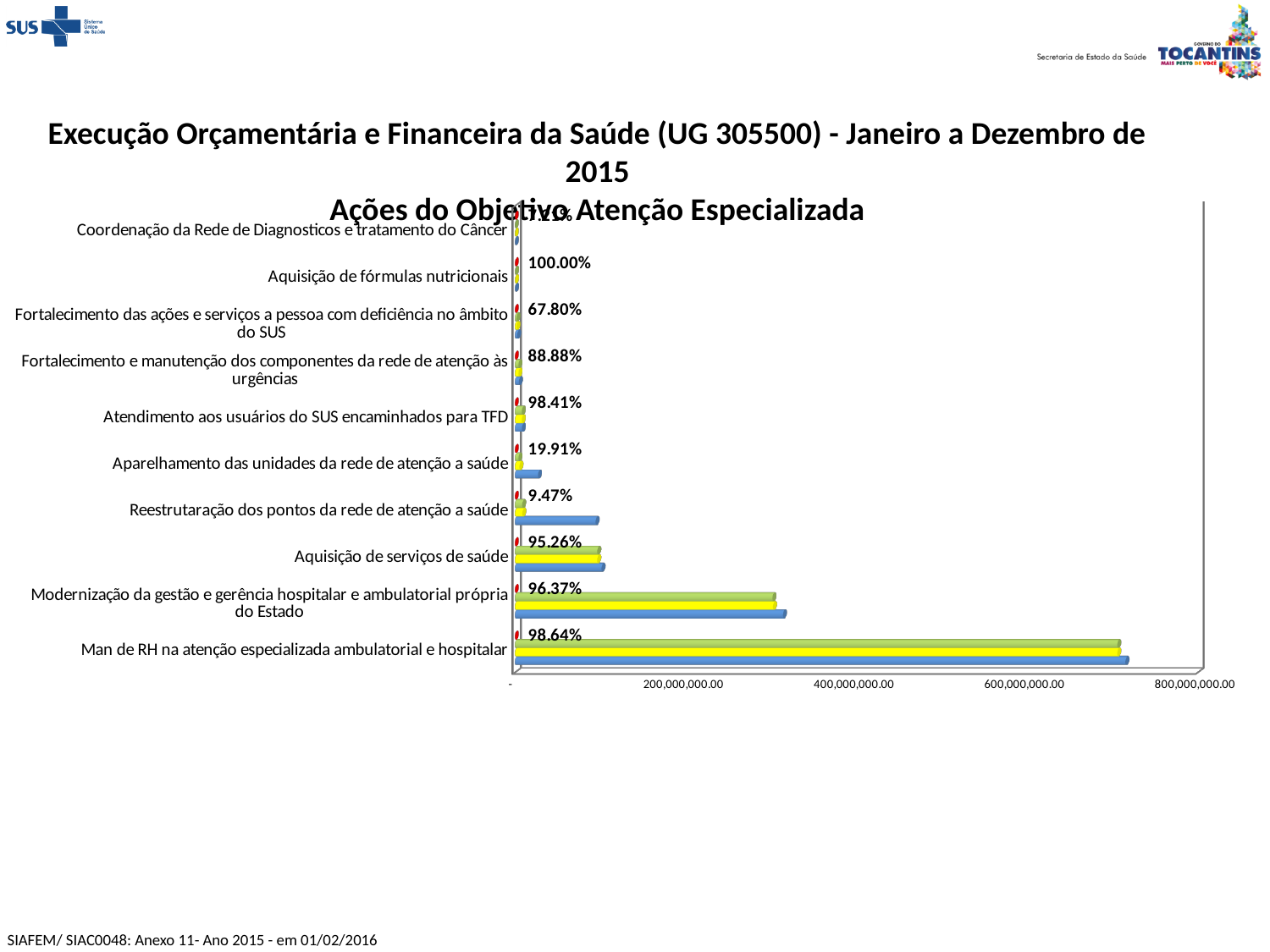
Are the bars for 'Man de RH na atenção especializada ambulatorial e hospitalar' greater or less than 600,000,000.00? greater What percentage is shown for 'Modernização da gestão e gerência hospitalar e ambulatorial própria do Estado'? 96.37% How many categories (actions) are listed on the chart? 10 What percentage is shown for 'Aquisição de fórmulas nutricionais'? 100.00% What percentage is shown for 'Reestruturação dos pontos da rede de atenção a saúde'? 9.47% What percentage is shown for 'Fortalecimento das ações e serviços a pessoa com deficiência no âmbito do SUS'? 67.80% What is the difference between the percentage for 'Aquisição de fórmulas nutricionais' and the percentage for 'Reestruturação dos pontos da rede de atenção a saúde'? 90.53% What percentage is shown for 'Aparelhamento das unidades da rede de atenção a saúde'? 19.91% Which category has the longest bars on the chart? Man de RH na atenção especializada ambulatorial e hospitalar What percentage is shown for 'Man de RH na atenção especializada ambulatorial e hospitalar'? 98.64% Which has longer bars: 'Modernização da gestão e gerência hospitalar e ambulatorial própria do Estado' or 'Aquisição de serviços de saúde'? Modernização da gestão e gerência hospitalar e ambulatorial própria do Estado What kind of chart is shown on the slide? bar chart